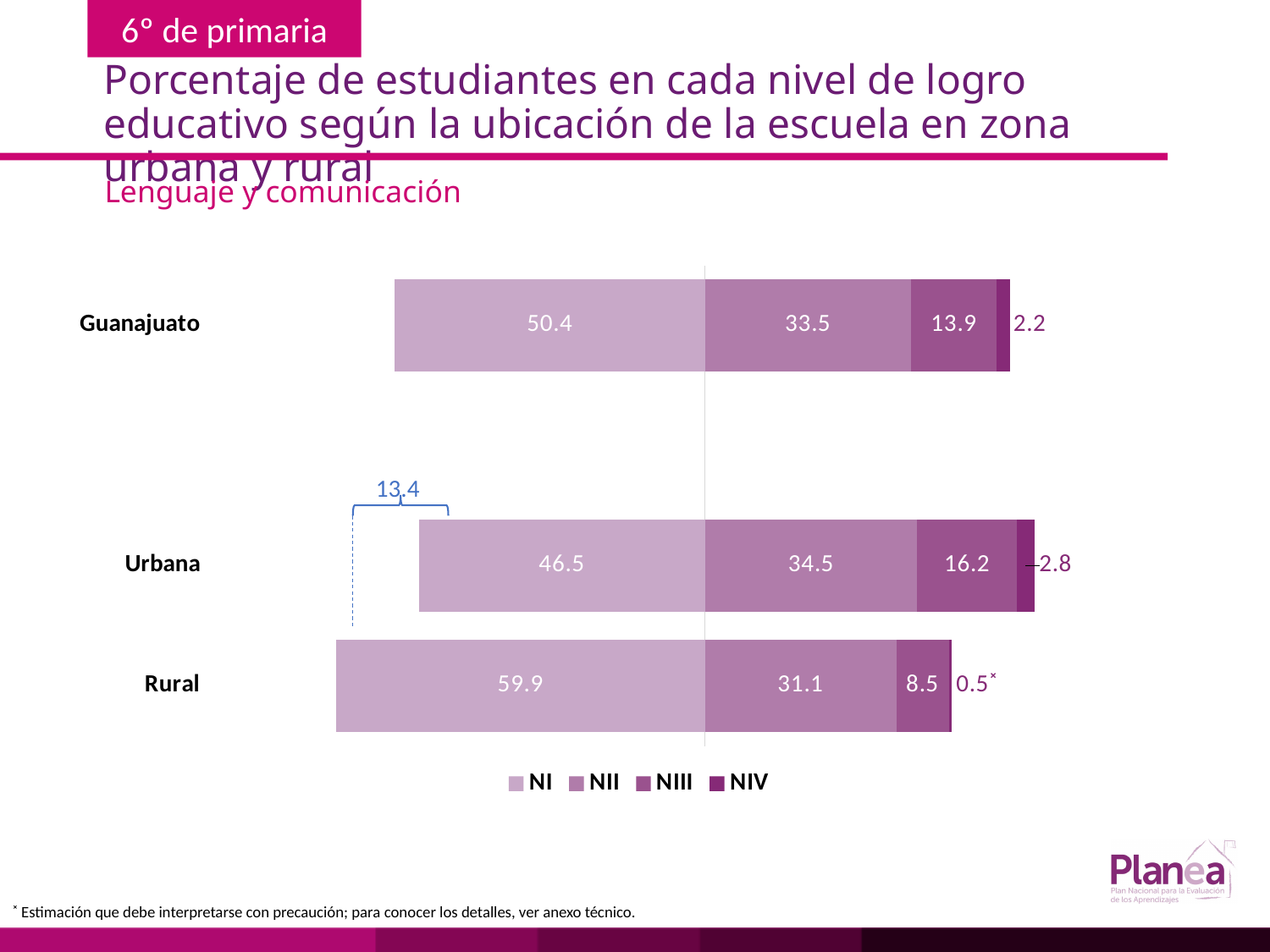
What type of chart is shown on the slide? stacked bar chart How many categories are plotted on the chart? 3 Which category has the lowest NIII value? Rural What is the NIII value for Urbana? 16.2 What is the NI value for Guanajuato? 50.4 How many series does the legend list? 4 What is the difference between the NI values for Rural and Urbana? 13.4 What is the NIV value for Rural? 0.5 Which is larger, the NII value for Urbana or the NII value for Guanajuato? Urbana Which category has the highest NI value? Rural What is the NII value for Rural? 31.1 What is the total of the stacked bar for Guanajuato? 100.0